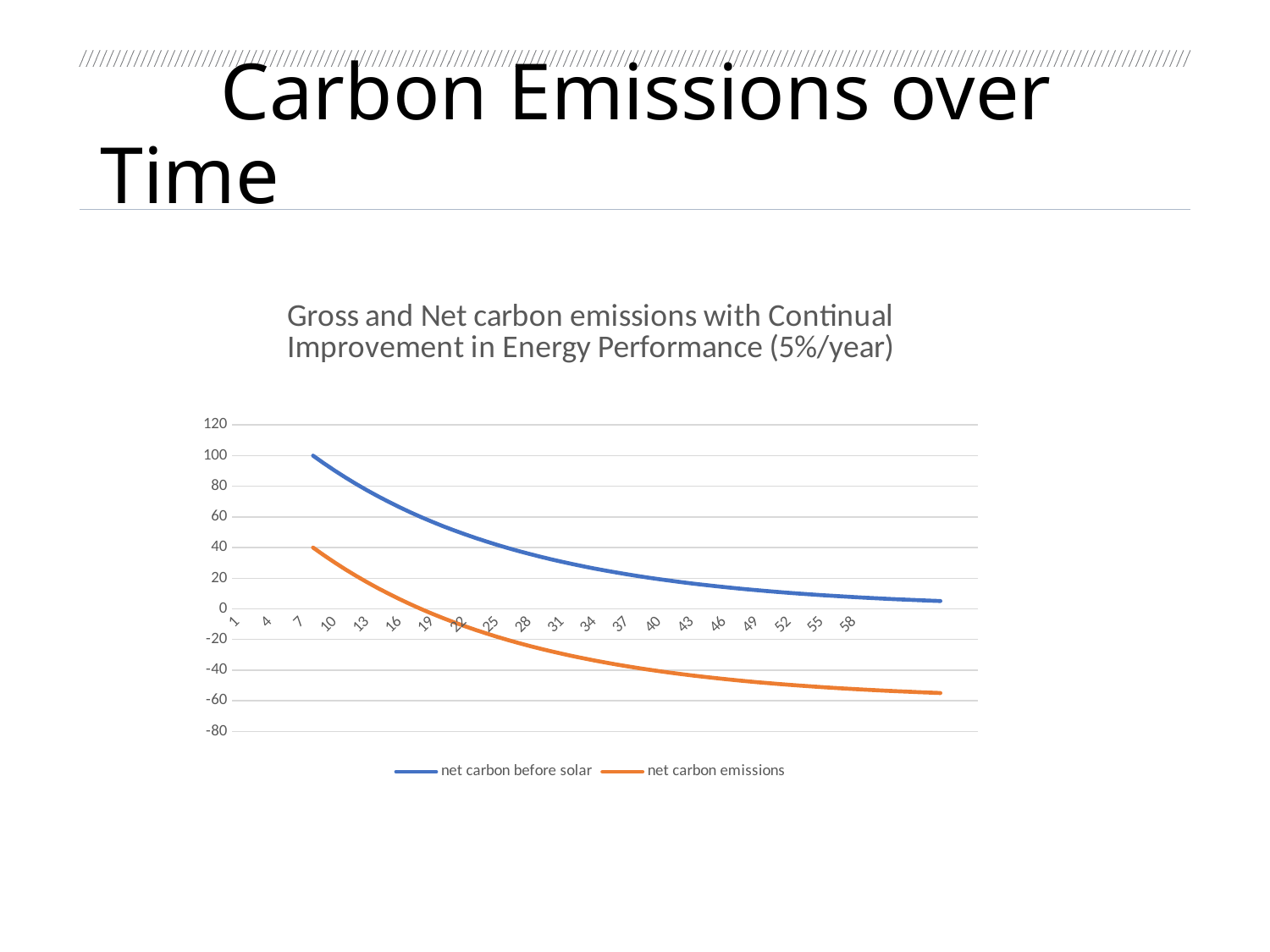
Do the values of the 'net carbon before solar' series rise or fall along the x axis? fall Which series has the higher value at x = 58, 'net carbon before solar' or 'net carbon emissions'? net carbon before solar Is the value for 'net carbon emissions' at x = 31 greater or less than 0? less Is the value for 'net carbon emissions' at x = 58 greater or less than -40? less What is the starting value of the 'net carbon emissions' line? 40 Is the value for 'net carbon before solar' at x = 58 greater or less than 20? less What is the starting value of the 'net carbon before solar' line? 100 How many series does the chart's legend list? 2 Which colour is used for the 'net carbon emissions' series? orange Do the values of the 'net carbon emissions' series rise or fall along the x axis? fall What is the title of the chart? Gross and Net carbon emissions with Continual Improvement in Energy Performance (5%/year) What kind of chart is shown on the slide? line chart